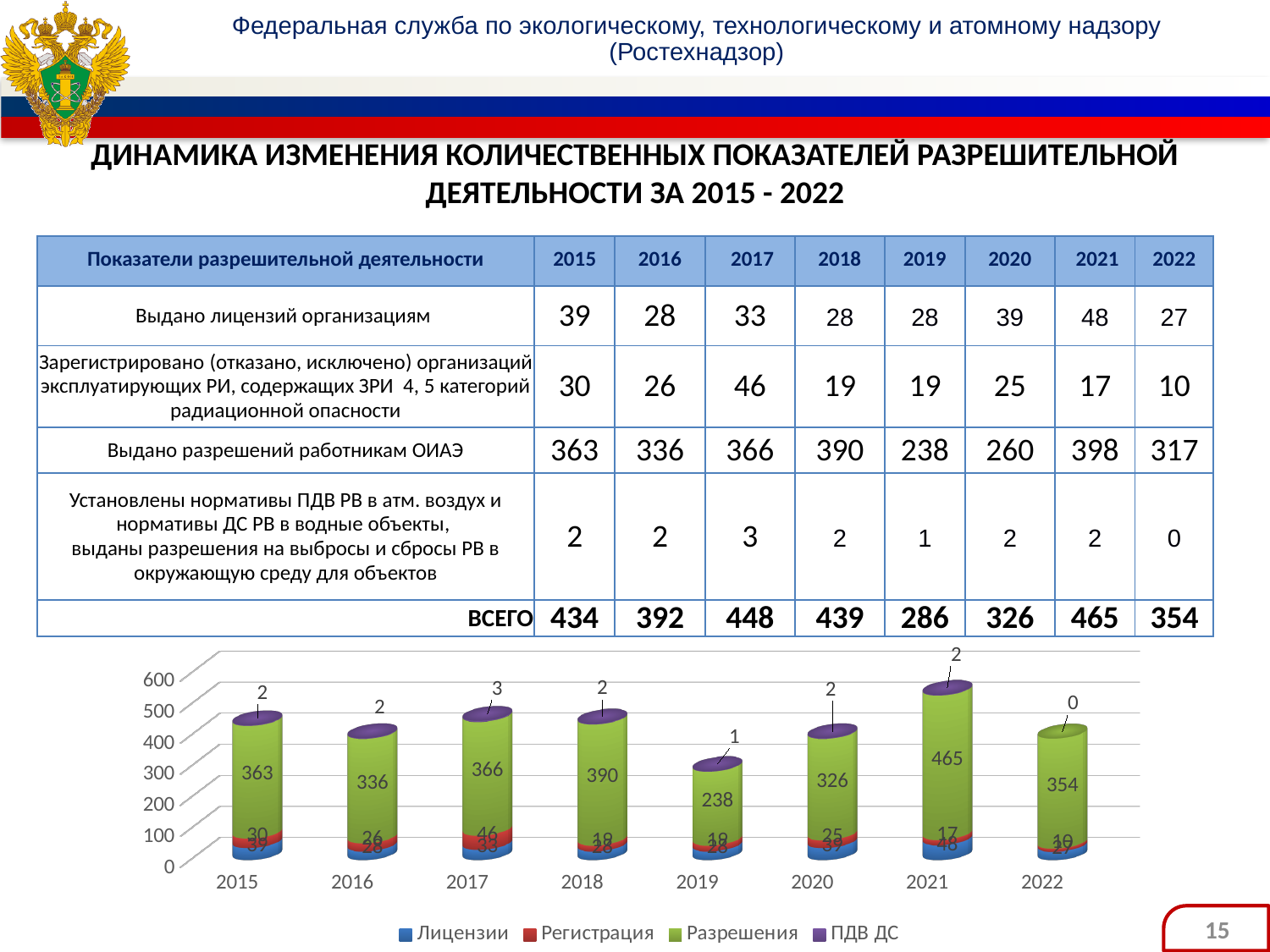
What is the difference between the Разрешения values for 2018 and 2019? 152 What is the value of Разрешения for 2018 in the chart? 390 Which colour represents Разрешения in the chart legend? green What is the value of ПДВ ДС for 2017 in the chart? 3 How many years are shown along the x axis of the chart? 8 In which year is the ПДВ ДС value the highest? 2017 What is the total of the stacked bar for 2019? 286 What kind of chart is shown at the bottom of the slide? stacked bar chart Which year has the larger Разрешения value, 2015 or 2016? 2015 What is the value of Лицензии for 2021? 48 How many series does the chart legend list? 4 In which year is the Разрешения value the lowest? 2019